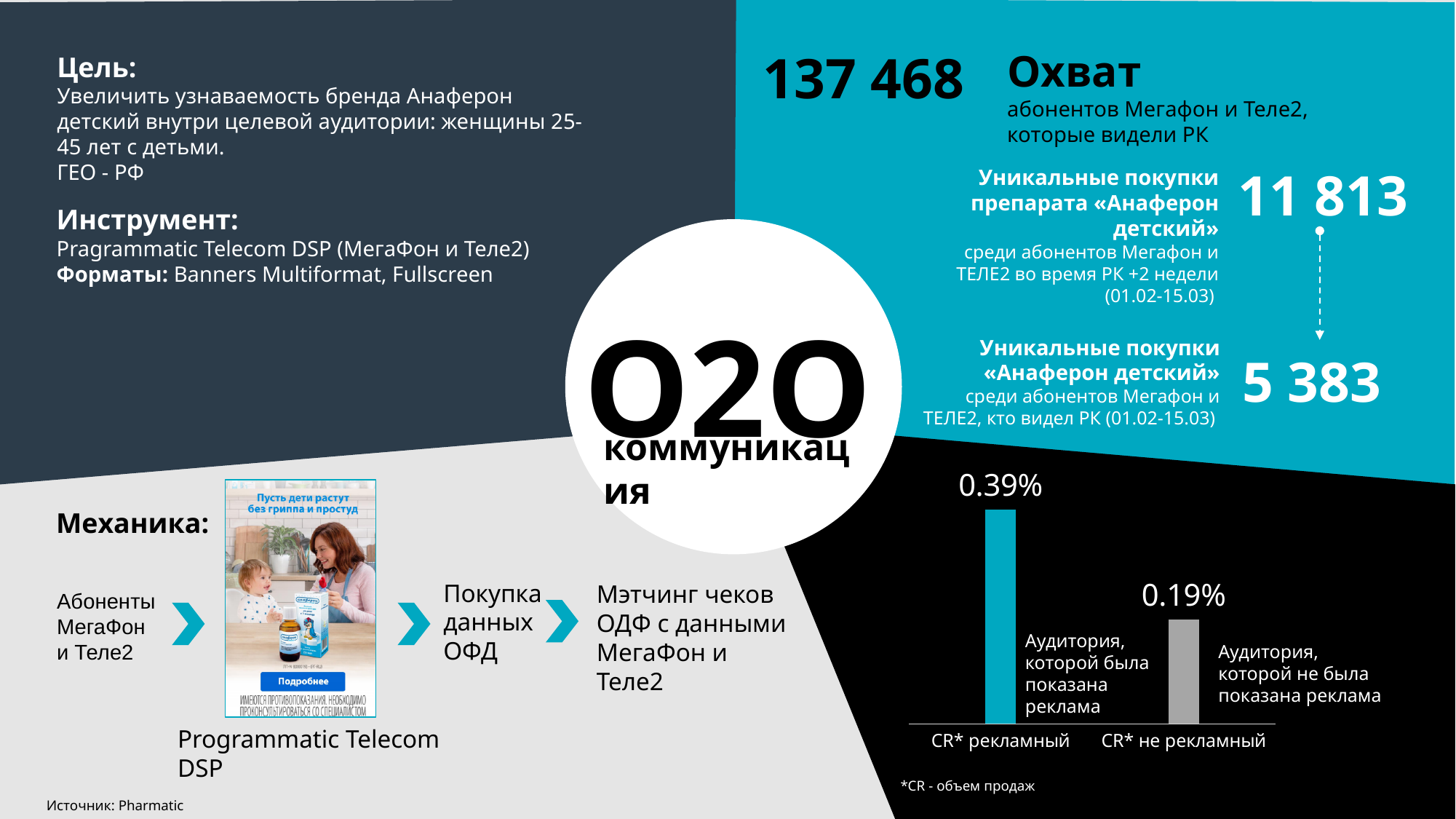
Which category in the bar chart has the lowest value? CR* не рекламный Which is larger in the bar chart: CR* рекламный or CR* не рекламный? CR* рекламный Which category in the bar chart has the highest value? CR* рекламный What colour is the bar for CR* рекламный in the bar chart? Teal (blue) What is the difference between the CR* рекламный and CR* не рекламный values in the bar chart? 0.20% What is the value for CR* рекламный in the bar chart? 0.39% How many bars are shown in the bar chart? 2 Do the values in the bar chart rise or fall from left to right? Fall According to the footnote under the bar chart, what does CR stand for? Объем продаж What is the value for CR* не рекламный in the bar chart? 0.19% What kind of chart is shown at the bottom right of the slide? Bar chart